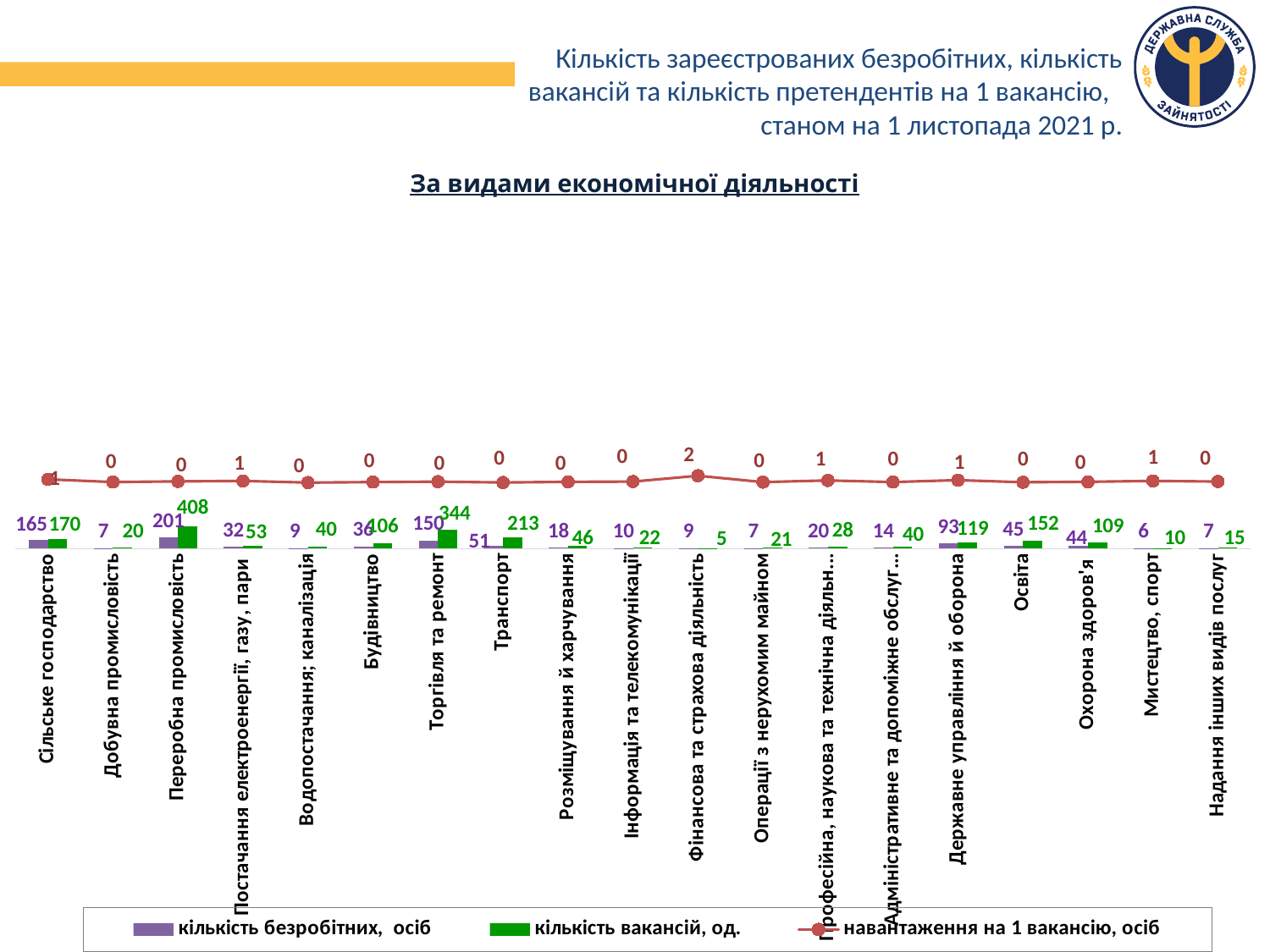
Which is larger for Освіта: the number of unemployed or the number of vacancies? the number of vacancies (152) What is the number of unemployed (кількість безробітних) for Сільське господарство? 165 What is the load per vacancy (навантаження на 1 вакансію) for Фінансова та страхова діяльність? 2 What colour are the bars for кількість вакансій, од.? Green How many series does the legend list? 3 Which category has the highest number of vacancies? Переробна промисловість What is the number of vacancies (кількість вакансій) for Переробна промисловість? 408 How many economic activity categories are shown on the x axis? 19 What kind of chart is this? A combined bar and line chart What is the difference between the number of vacancies and the number of unemployed for Торгівля та ремонт? 194 Which category has the lowest number of unemployed? Мистецтво, спорт Which category has the lowest number of vacancies? Фінансова та страхова діяльність